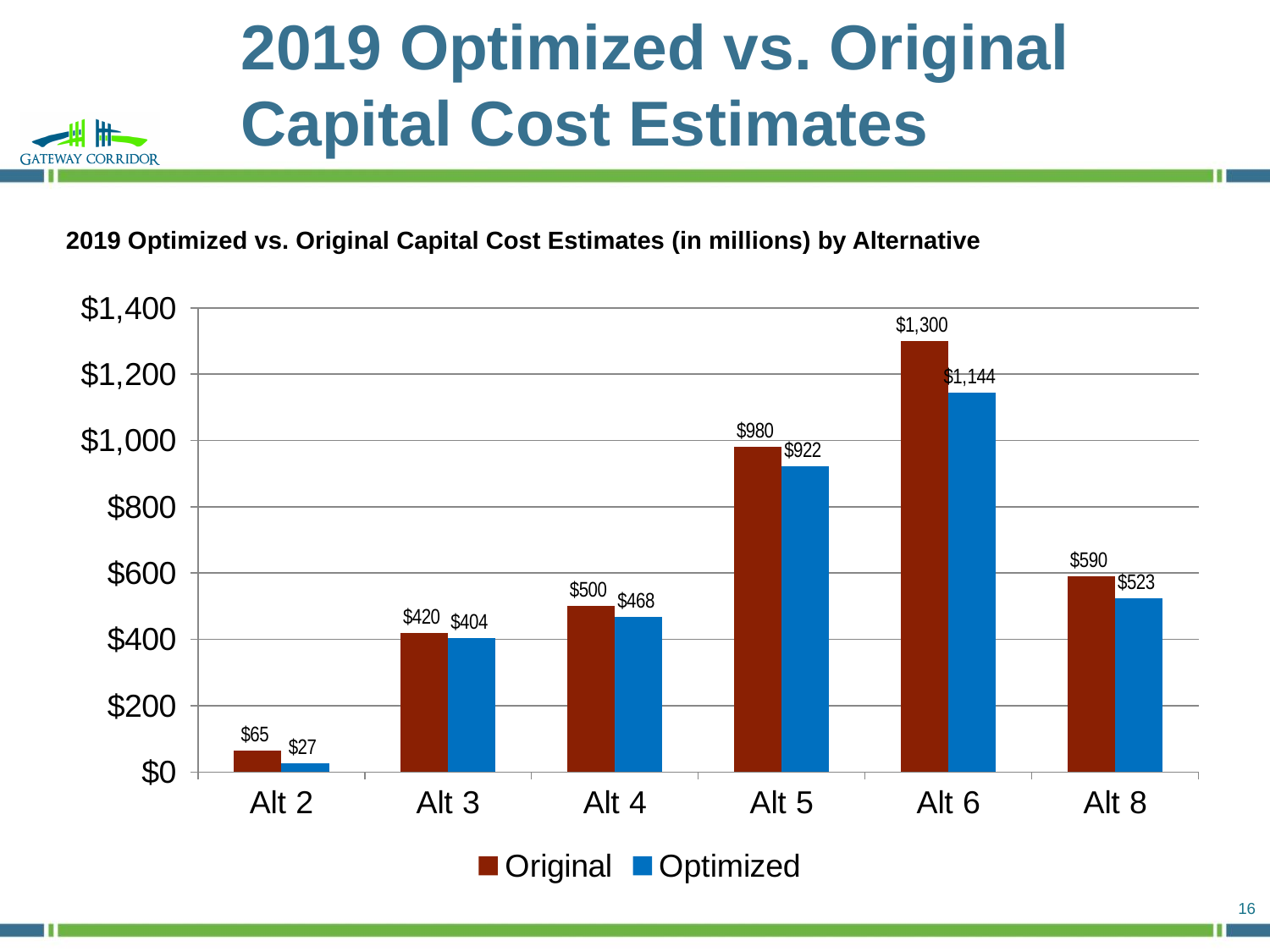
What is the difference between the Original and Optimized estimates for Alt 8? $67 What is the Original capital cost estimate for Alt 5? $980 How many alternatives are shown on the x axis? 6 Which colour represents the Optimized series in the legend? Blue Which is larger, the Optimized estimate for Alt 5 or the Original estimate for Alt 8? Optimized estimate for Alt 5 Which alternative has the highest Original capital cost estimate? Alt 6 Which alternative has the lowest Optimized capital cost estimate? Alt 2 What is the difference between the Original and Optimized estimates for Alt 6? $156 How many series does the legend list? 2 What is the Optimized value for Alt 2? $27 What kind of chart is shown on the slide? Bar chart What is the Optimized capital cost estimate for Alt 6? $1,144